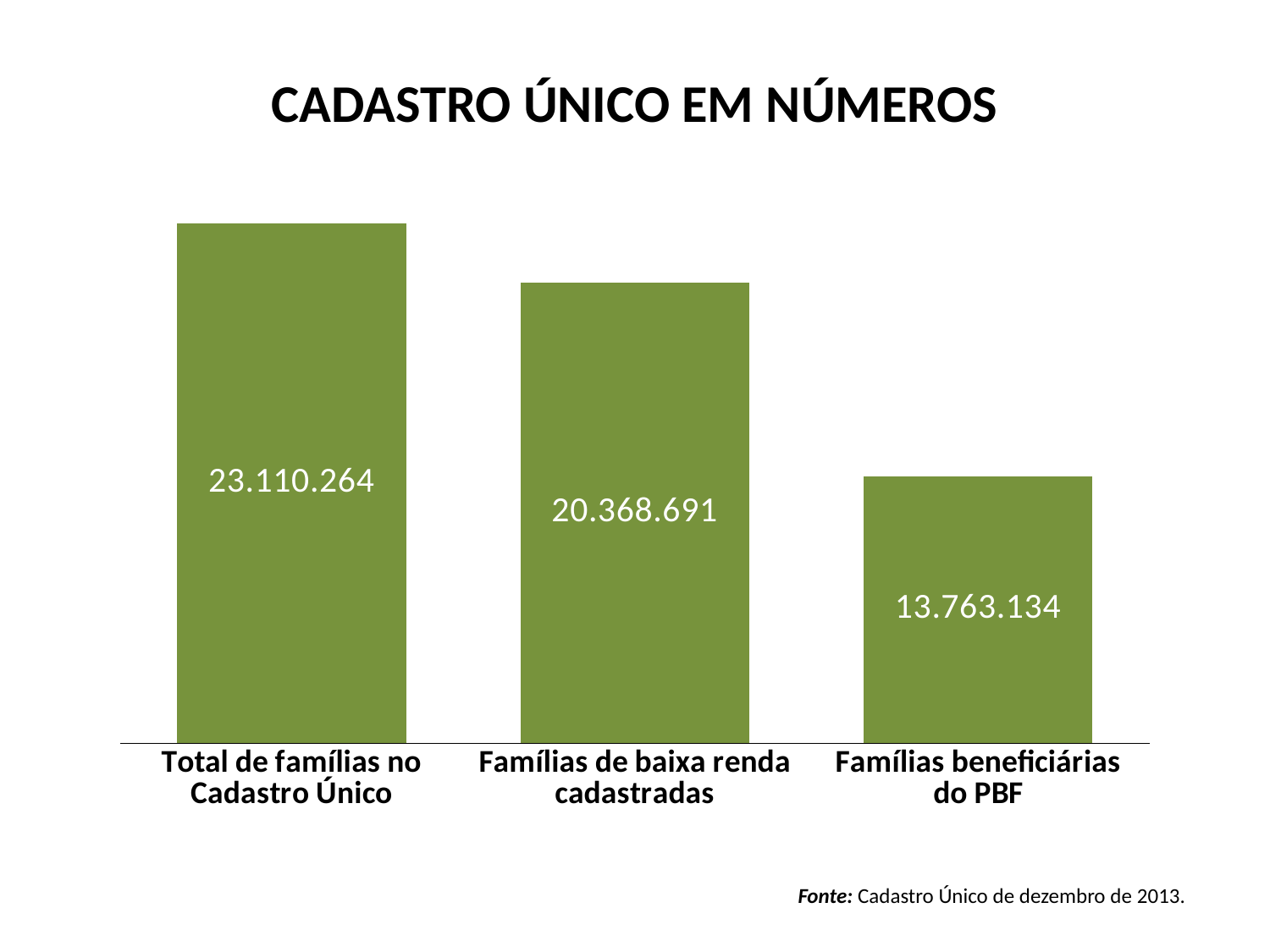
What is the difference between "Total de famílias no Cadastro Único" and "Famílias beneficiárias do PBF"? 9.347.130 How many categories are shown in the chart? 3 What is the difference between "Total de famílias no Cadastro Único" and "Famílias de baixa renda cadastradas"? 2.741.573 What is the value for "Total de famílias no Cadastro Único"? 23.110.264 What is the difference between "Famílias de baixa renda cadastradas" and "Famílias beneficiárias do PBF"? 6.605.557 Which is larger: "Famílias de baixa renda cadastradas" or "Famílias beneficiárias do PBF"? Famílias de baixa renda cadastradas Which category has the highest value? Total de famílias no Cadastro Único What is the value for "Famílias de baixa renda cadastradas"? 20.368.691 What is the value for "Famílias beneficiárias do PBF"? 13.763.134 What kind of chart is shown on the slide? Bar chart Which category has the lowest value? Famílias beneficiárias do PBF What is the title of the chart? CADASTRO ÚNICO EM NÚMEROS